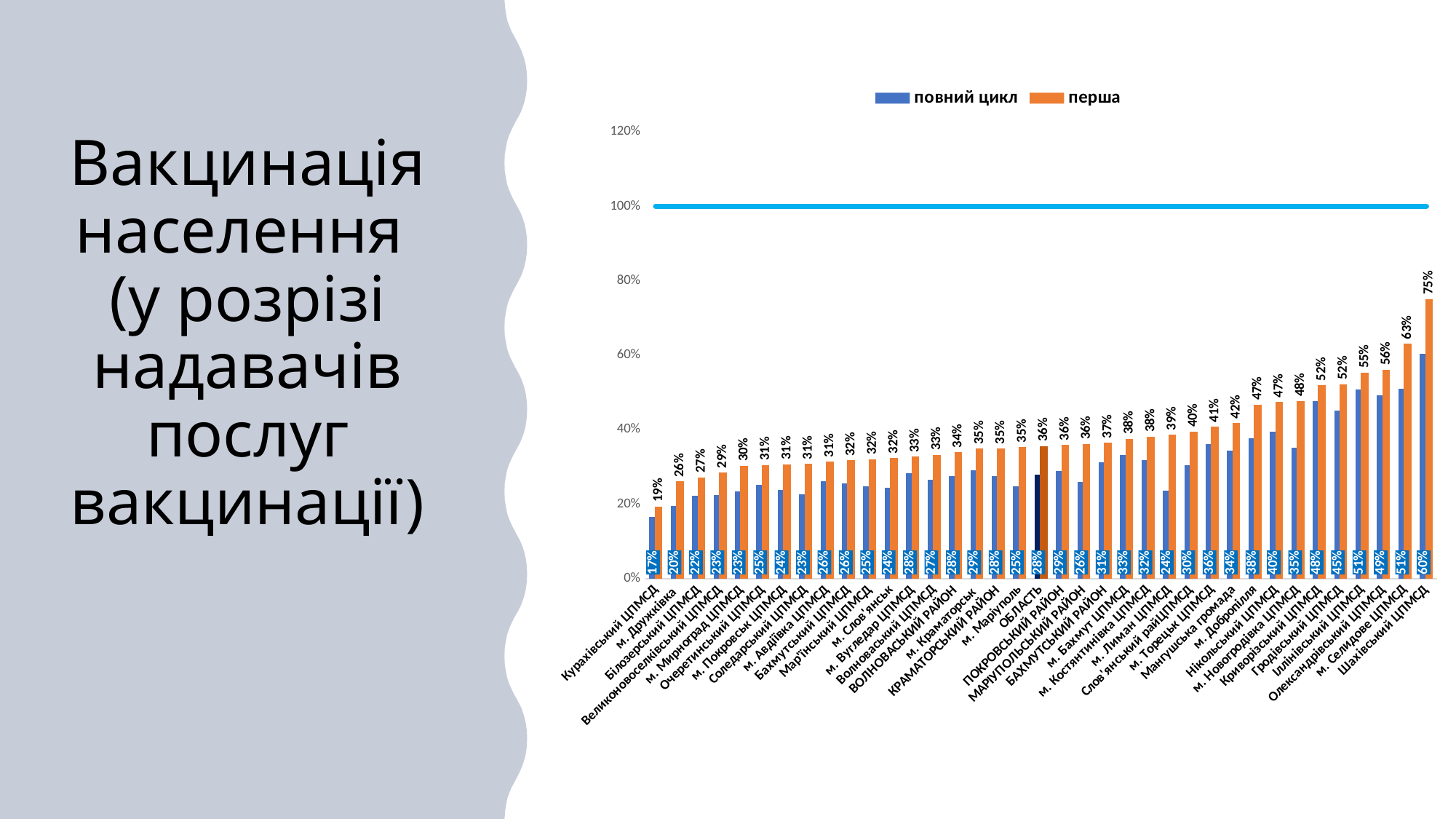
What type of chart is shown on the slide? bar chart How many series does the legend list? 2 What is the value of "перша" for Шахівський ЦПМСД? 75% Which category has the highest "повний цикл" value? Шахівський ЦПМСД What is the difference between the "перша" and "повний цикл" values for Шахівський ЦПМСД? 15% Which is larger: the "повний цикл" value for м. Добропілля or for Нікольський ЦПМСД? Нікольський ЦПМСД What are the two series named in the legend? повний цикл, перша What is the value of "повний цикл" for ОБЛАСТЬ? 28% Which category has the lowest "перша" value? Курахівський ЦПМСД At what level is the horizontal blue reference line drawn? 100% Do the "перша" values rise or fall from left to right along the x axis? rise What is the value of "перша" for м. Селидове ЦПМСД? 63%